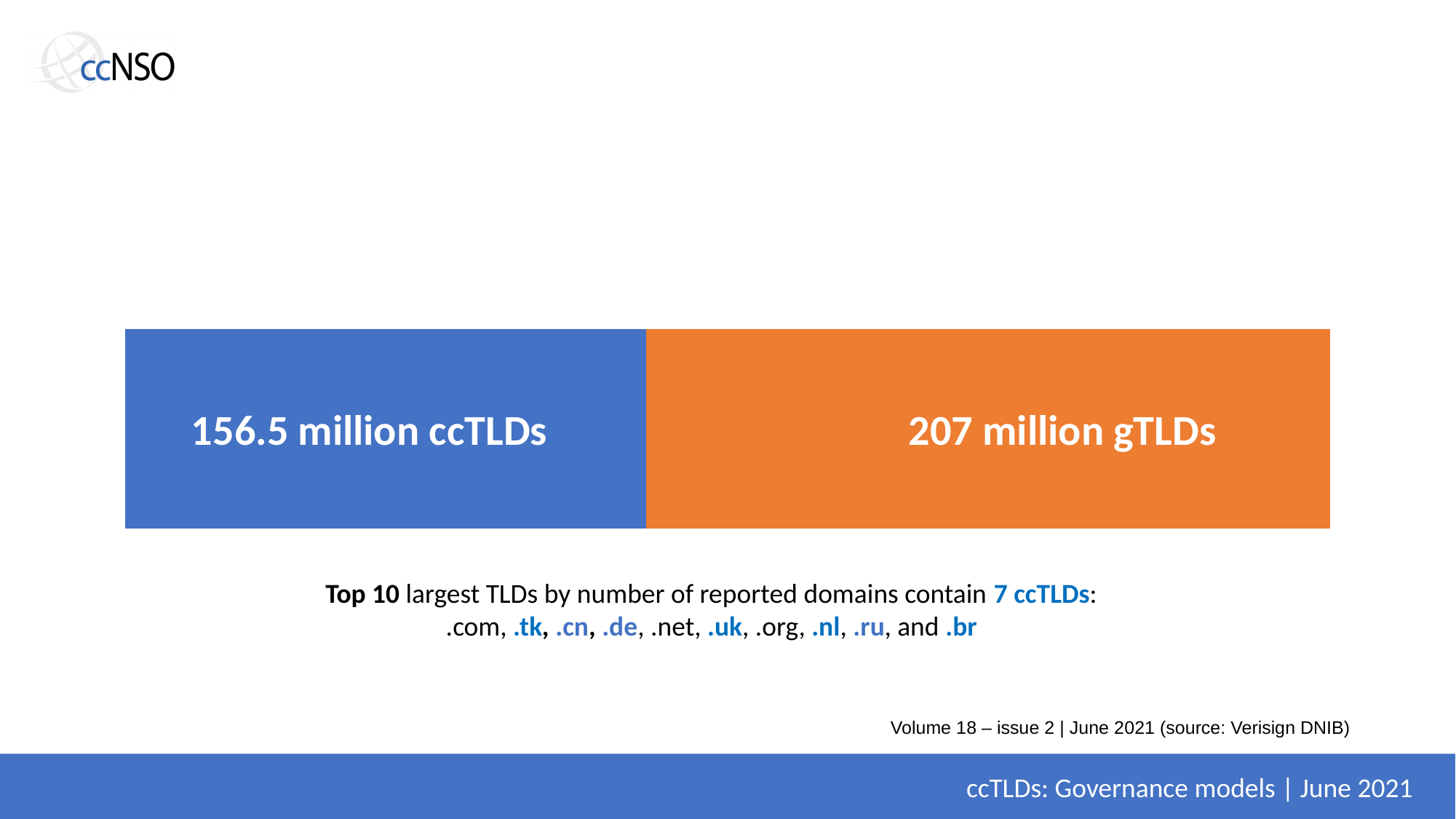
How many domains are reported for ccTLDs in the bar? 156.5 million What kind of chart is shown on the slide? Bar chart How many segments does the stacked bar contain? 2 Is the value for ccTLDs greater or less than 200 million? less How many domains are reported for gTLDs in the bar? 207 million What is the difference between the gTLD and ccTLD domain counts shown? 50.5 million What is the combined total of ccTLDs and gTLDs shown in the bar? 363.5 million What colour is the gTLDs segment of the bar? Orange What colour is the ccTLDs segment of the bar? Blue Which category has the smaller number of domains? ccTLDs Which category has the larger number of domains? gTLDs Which segment of the bar is larger, ccTLDs or gTLDs? gTLDs